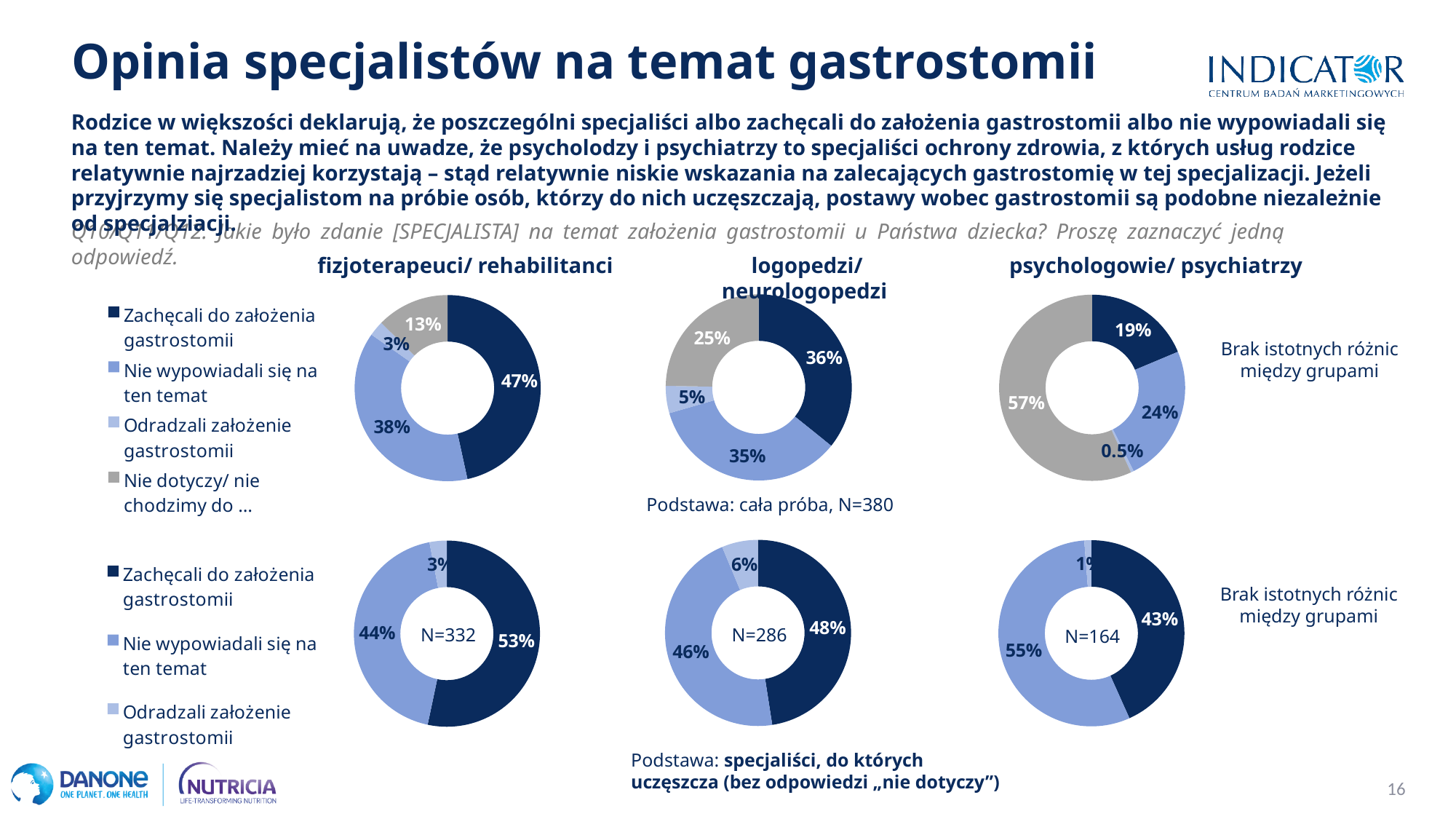
How many categories does the legend for the top row of charts list? 4 What is the sample size shown in the centre of the bottom-row chart for 'logopedzi/ neurologopedzi'? N=286 In the bottom-row chart labelled N=332, which is larger: 'Zachęcali do założenia gastrostomii' or 'Nie wypowiadali się na ten temat'? Zachęcali do założenia gastrostomii In the top-row 'fizjoterapeuci/ rehabilitanci' chart, which category has the largest share? Zachęcali do założenia gastrostomii In the top-row 'fizjoterapeuci/ rehabilitanci' chart, what share of parents said the specialist encouraged gastrostomy ('Zachęcali do założenia gastrostomii')? 47% In the top-row 'logopedzi/ neurologopedzi' chart, what is the difference between the 'Zachęcali do założenia gastrostomii' and 'Nie wypowiadali się na ten temat' shares? 1% In the top-row 'psychologowie/ psychiatrzy' chart, what is the value of the 'Nie dotyczy/ nie chodzimy do …' slice? 57% In the top-row 'psychologowie/ psychiatrzy' chart, which category has the smallest share? Odradzali założenie gastrostomii In the bottom-row chart labelled N=164, what is the difference between the 'Nie wypowiadali się na ten temat' share and the 'Zachęcali do założenia gastrostomii' share? 12% In the top-row 'logopedzi/ neurologopedzi' chart, what is the value of the 'Odradzali założenie gastrostomii' slice? 5% In the bottom-row chart labelled N=286, what share is 'Odradzali założenie gastrostomii'? 6% What type of chart is used on this slide? Donut (pie) chart